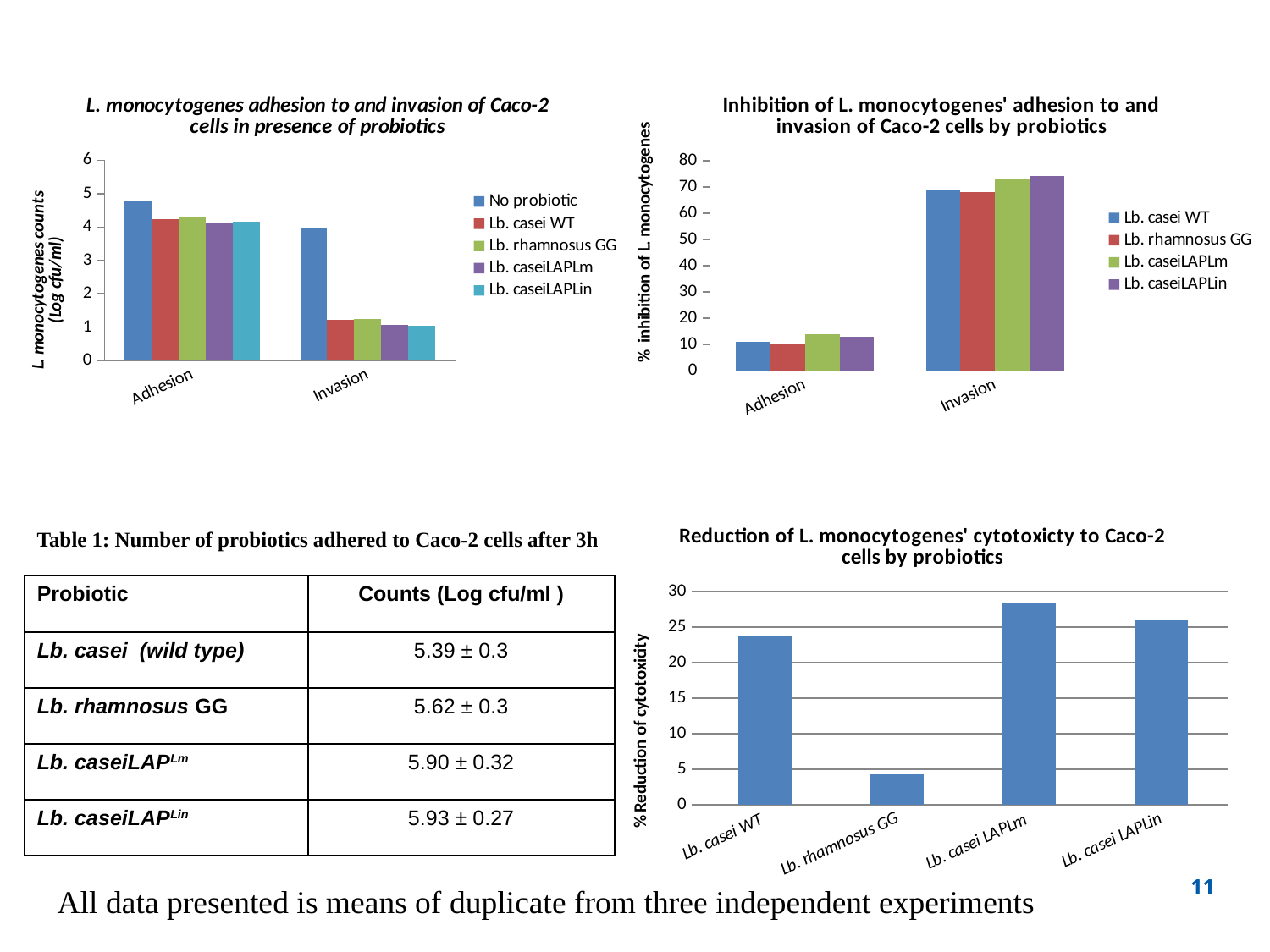
In the top-left chart 'L. monocytogenes adhesion to and invasion of Caco-2 cells in presence of probiotics', is the No probiotic value larger for Adhesion or for Invasion? Adhesion In the top-left chart 'L. monocytogenes adhesion to and invasion of Caco-2 cells in presence of probiotics', is the Invasion value for No probiotic greater or less than 3? greater In the bottom-right chart 'Reduction of L. monocytogenes' cytotoxicty to Caco-2 cells by probiotics', which probiotic has the lowest % reduction of cytotoxicity? Lb. rhamnosus GG In the top-left chart 'L. monocytogenes adhesion to and invasion of Caco-2 cells in presence of probiotics', is the Invasion value for Lb. casei WT greater or less than 2? less What kind of chart is the bottom-right chart titled 'Reduction of L. monocytogenes' cytotoxicty to Caco-2 cells by probiotics'? bar chart In the top-left chart 'L. monocytogenes adhesion to and invasion of Caco-2 cells in presence of probiotics', how many series does the legend list? 5 In the bottom-right chart 'Reduction of L. monocytogenes' cytotoxicty to Caco-2 cells by probiotics', which probiotic has the highest % reduction of cytotoxicity? Lb. casei LAPLm In the bottom-right chart 'Reduction of L. monocytogenes' cytotoxicty to Caco-2 cells by probiotics', is the value for Lb. rhamnosus GG greater or less than 5? less In the top-right chart 'Inhibition of L. monocytogenes' adhesion to and invasion of Caco-2 cells by probiotics', is the Lb. caseiLAPLm value larger for Adhesion or for Invasion? Invasion In the top-right chart 'Inhibition of L. monocytogenes' adhesion to and invasion of Caco-2 cells by probiotics', how many series does the legend list? 4 In the bottom-right chart 'Reduction of L. monocytogenes' cytotoxicty to Caco-2 cells by probiotics', how many probiotic categories are shown on the x axis? 4